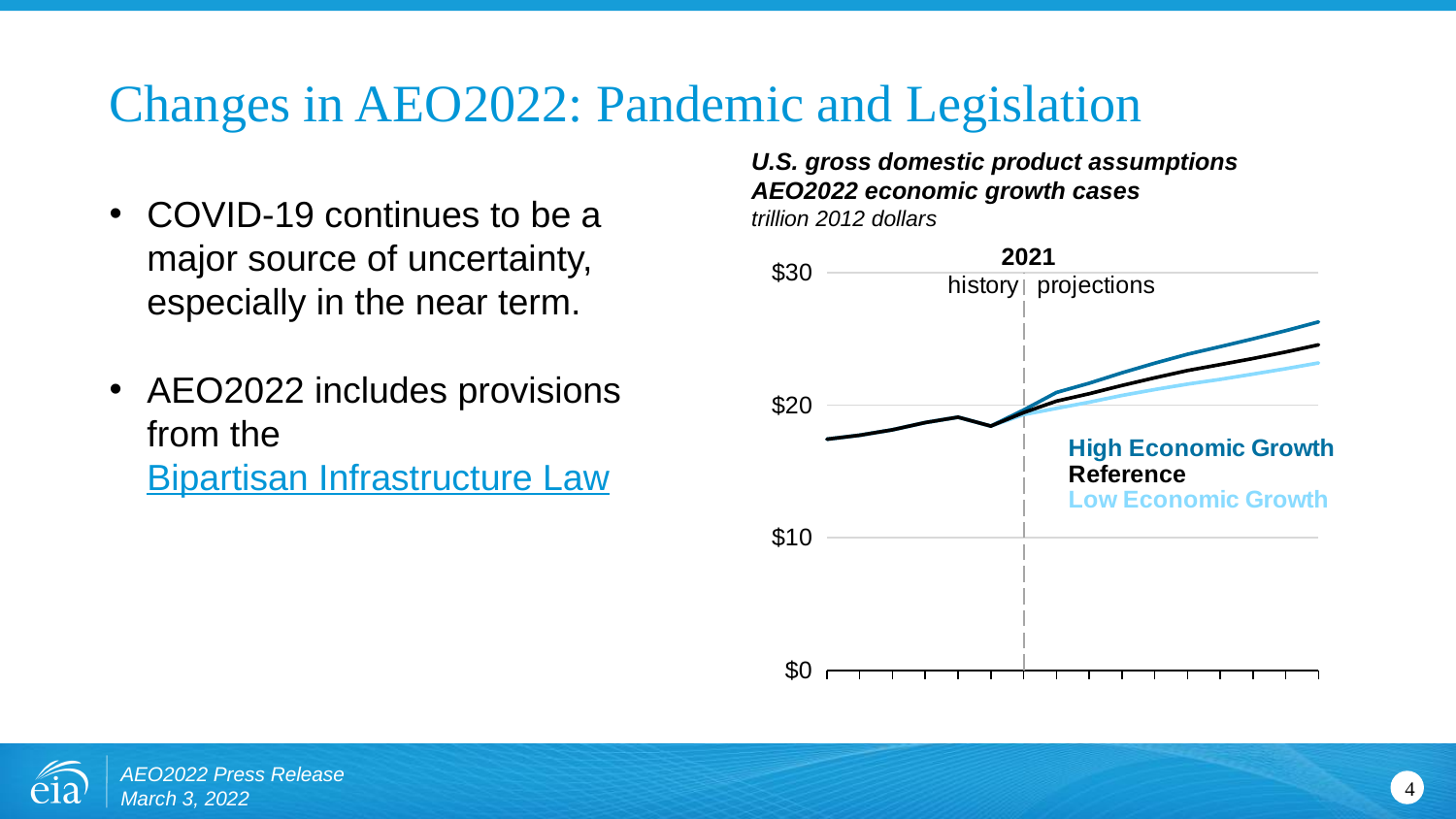
Is the value at the left end of the history line greater or less than $20? less What year marks the boundary between history and projections on the chart? 2021 What unit is the chart's y axis measured in? trillion 2012 dollars Which series is lowest at the right end of the chart? Low Economic Growth What kind of chart is shown on the slide? line chart Is the value of the Reference line at the right end of the chart greater or less than $30? less Do the projected lines generally rise or fall from left to right after 2021? rise At the right end of the chart, which is larger: the High Economic Growth line or the Low Economic Growth line? High Economic Growth Which series is highest at the right end of the chart? High Economic Growth How many series does the chart's legend list? 3 Is the value of the High Economic Growth line at the right end of the chart greater or less than $20? greater